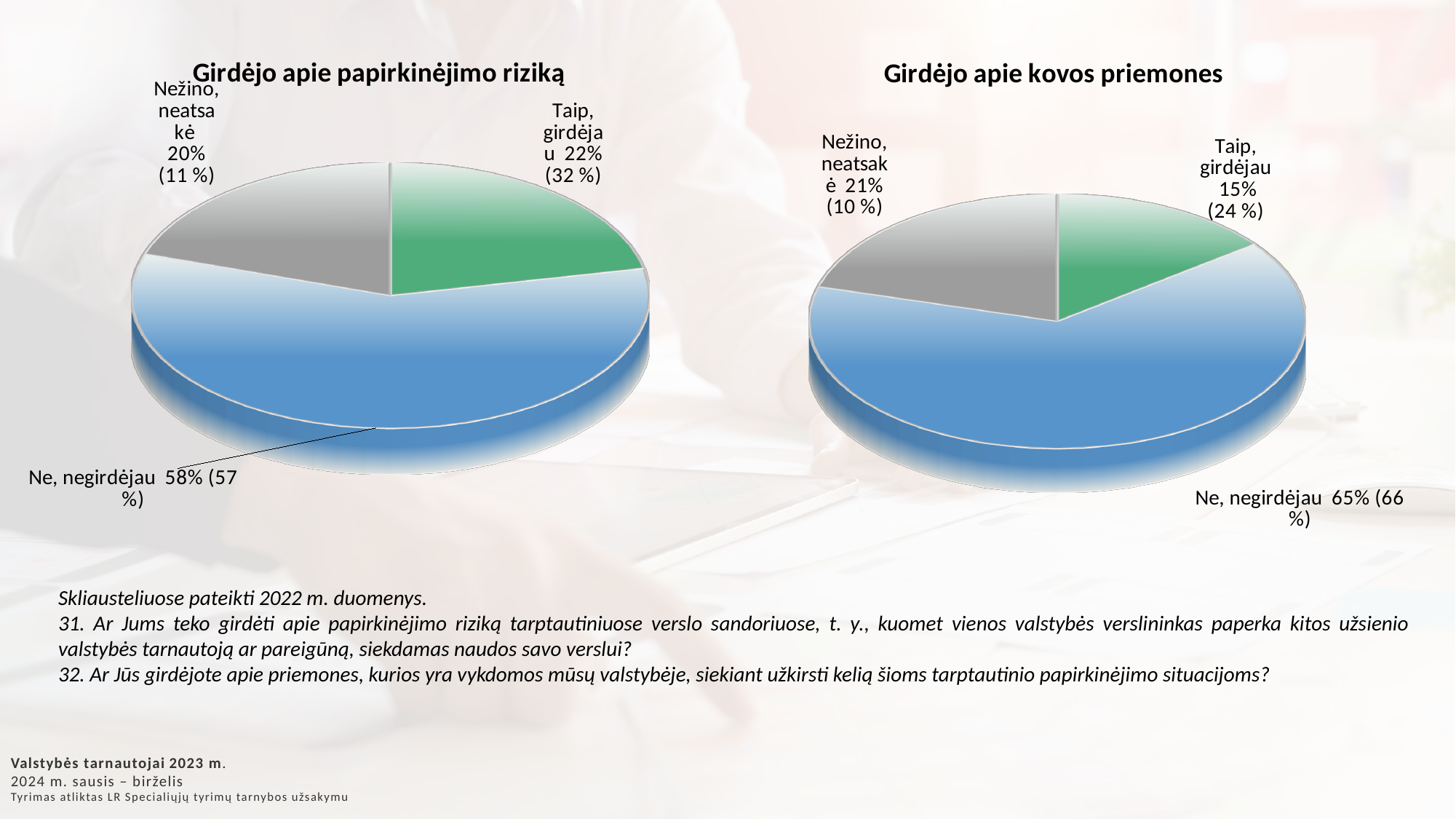
How many slices does the chart titled "Girdėjo apie papirkinėjimo riziką" have? 3 In the chart titled "Girdėjo apie kovos priemones", what 2022 value (in parentheses) is shown for "Taip, girdėjau"? 24 % In the chart titled "Girdėjo apie papirkinėjimo riziką", which category has the largest slice? Ne, negirdėjau In the chart titled "Girdėjo apie kovos priemones", what is the difference in percentage points between "Ne, negirdėjau" (65%) and "Taip, girdėjau" (15%)? 50 Which is larger: "Taip, girdėjau" in the chart "Girdėjo apie papirkinėjimo riziką" or "Taip, girdėjau" in the chart "Girdėjo apie kovos priemones"? Girdėjo apie papirkinėjimo riziką In the chart titled "Girdėjo apie papirkinėjimo riziką", what colour is the "Ne, negirdėjau" slice? Blue What type of chart is the chart titled "Girdėjo apie kovos priemones"? Pie chart In the chart titled "Girdėjo apie papirkinėjimo riziką", what percentage is shown for "Ne, negirdėjau" (the main value, not the one in parentheses)? 58% In the chart titled "Girdėjo apie papirkinėjimo riziką", what percentage is shown for "Taip, girdėjau" (the main value, not the one in parentheses)? 22% In the chart titled "Girdėjo apie kovos priemones", which category has the smallest slice? Taip, girdėjau In the chart titled "Girdėjo apie kovos priemones", what percentage is shown for "Nežino, neatsakė" (the main value, not the one in parentheses)? 21% What is the title of the pie chart on the right side of the slide? Girdėjo apie kovos priemones